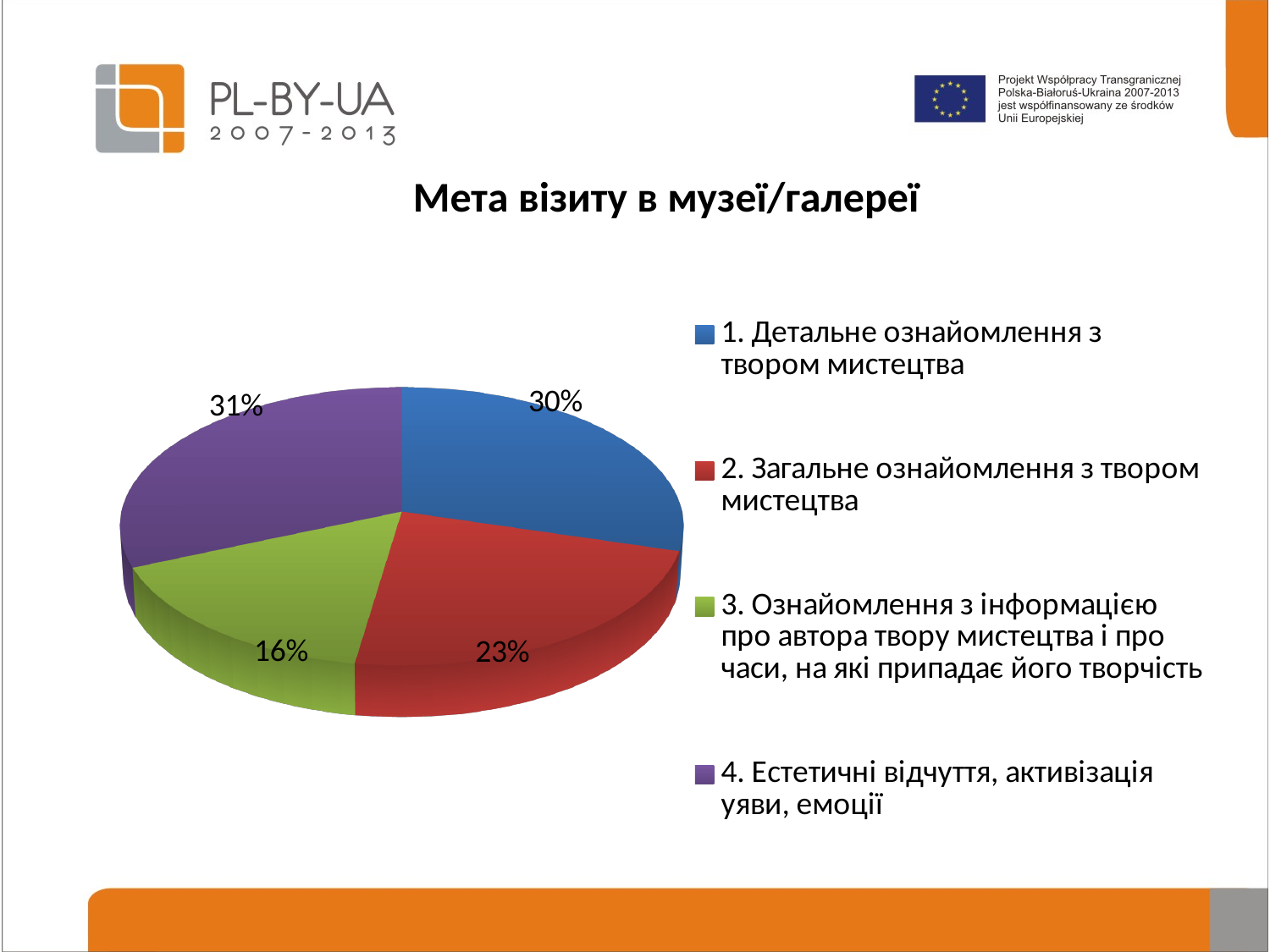
What is the difference in percentage points between "2. Загальне ознайомлення з твором мистецтва" and "3. Ознайомлення з інформацією про автора твору мистецтва і про часи, на які припадає його творчість"? 7% Which is larger: the share for "1. Детальне ознайомлення з твором мистецтва" or the share for "2. Загальне ознайомлення з твором мистецтва"? 1. Детальне ознайомлення з твором мистецтва What is the title of the chart? Мета візиту в музеї/галереї How many slices does the pie chart have? 4 Which category has the largest share of the pie? 4. Естетичні відчуття, активізація уяви, емоції What share of the pie is "1. Детальне ознайомлення з твором мистецтва"? 30% What type of chart is shown on the slide? Pie chart What share of the pie is "2. Загальне ознайомлення з твором мистецтва"? 23% What share of the pie is "4. Естетичні відчуття, активізація уяви, емоції"? 31% Which category has the smallest share of the pie? 3. Ознайомлення з інформацією про автора твору мистецтва і про часи, на які припадає його творчість What colour is the slice for "3. Ознайомлення з інформацією про автора твору мистецтва і про часи, на які припадає його творчість"? Green